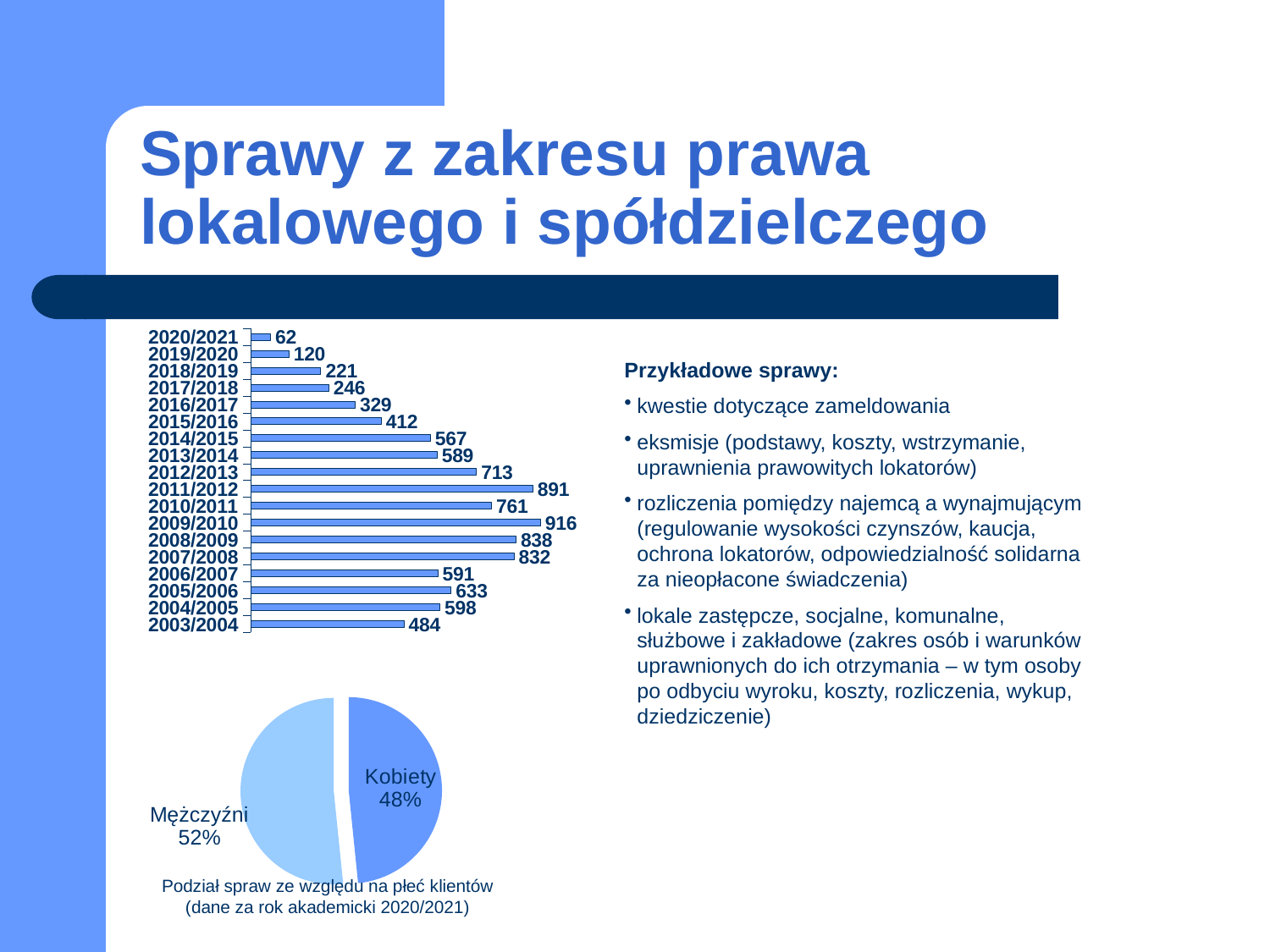
In the pie chart at the bottom left, what share is labelled Kobiety? 48% In the bar chart at the top left, what is the value for 2009/2010? 916 In the bar chart at the top left, which is larger, the value for 2005/2006 or the value for 2004/2005? 2005/2006 In the bar chart at the top left, which academic year has the highest value? 2009/2010 In the bar chart at the top left, which academic year has the lowest value? 2020/2021 In the bar chart at the top left, what is the difference between the values for 2011/2012 and 2010/2011? 130 In the pie chart at the bottom left, which slice is larger, Kobiety or Mężczyźni? Mężczyźni What type of chart is shown at the top left of the slide? Bar chart What is the caption below the pie chart at the bottom left? Podział spraw ze względu na płeć klientów (dane za rok akademicki 2020/2021) How many academic years are shown in the bar chart at the top left? 18 In the bar chart at the top left, what is the value for 2015/2016? 412 In the bar chart at the top left, what is the value for 2003/2004? 484